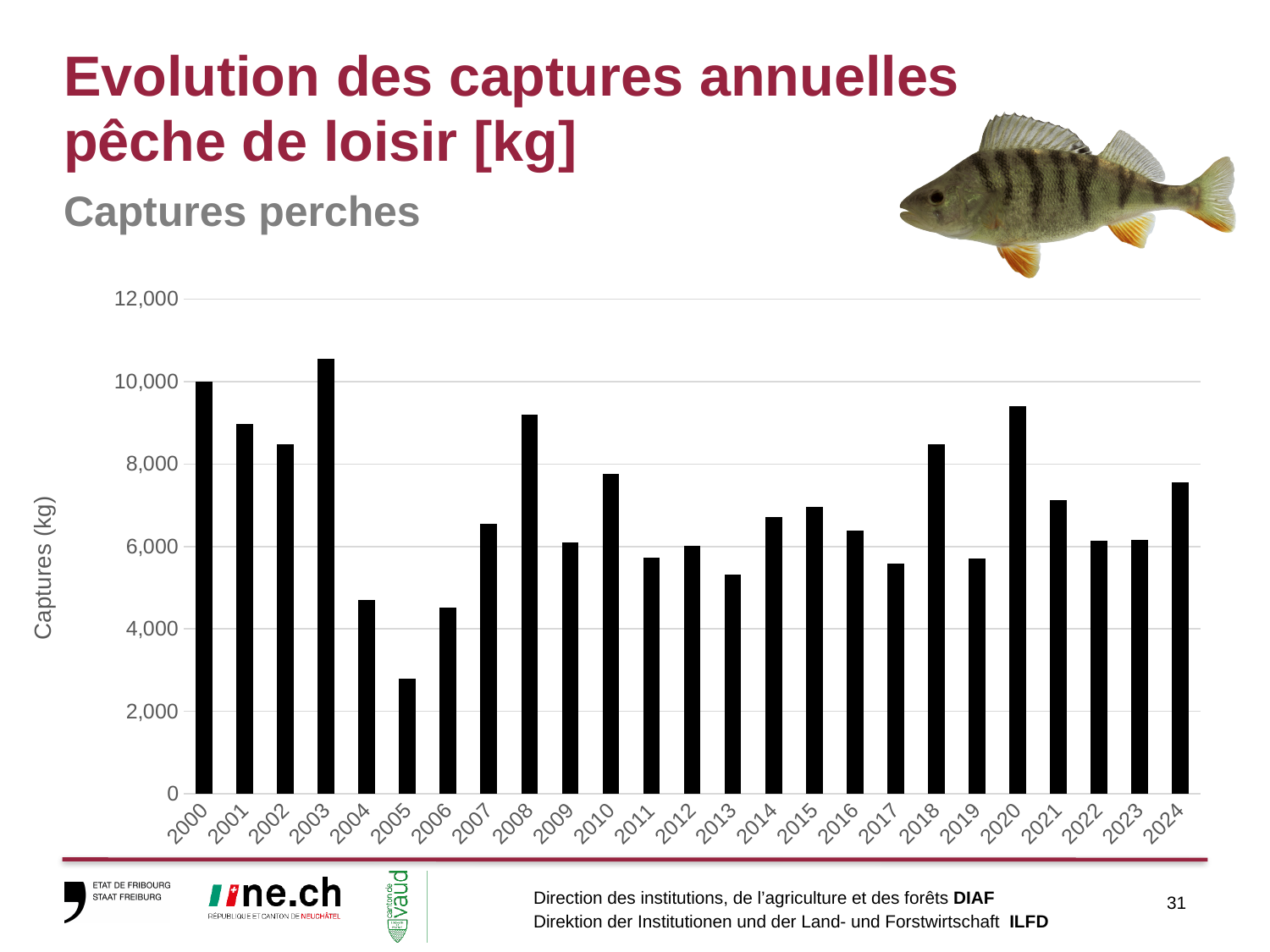
Which year has the lowest perch catch in the chart? 2005 Which year has the larger catch, 2004 or 2024? 2024 Is the value for 2003 greater or less than 10,000? greater Is the value for 2005 greater or less than 4,000? less What is the label of the y axis of the chart? Captures (kg) How many years (bars) are shown on the x axis of the chart? 25 What kind of chart is shown on the slide? bar chart Is the value for 2013 greater or less than 6,000? less Which year has the highest perch catch in the chart? 2003 Do the values rise or fall from 2003 to 2005? fall Which year has the larger catch, 2008 or 2009? 2008